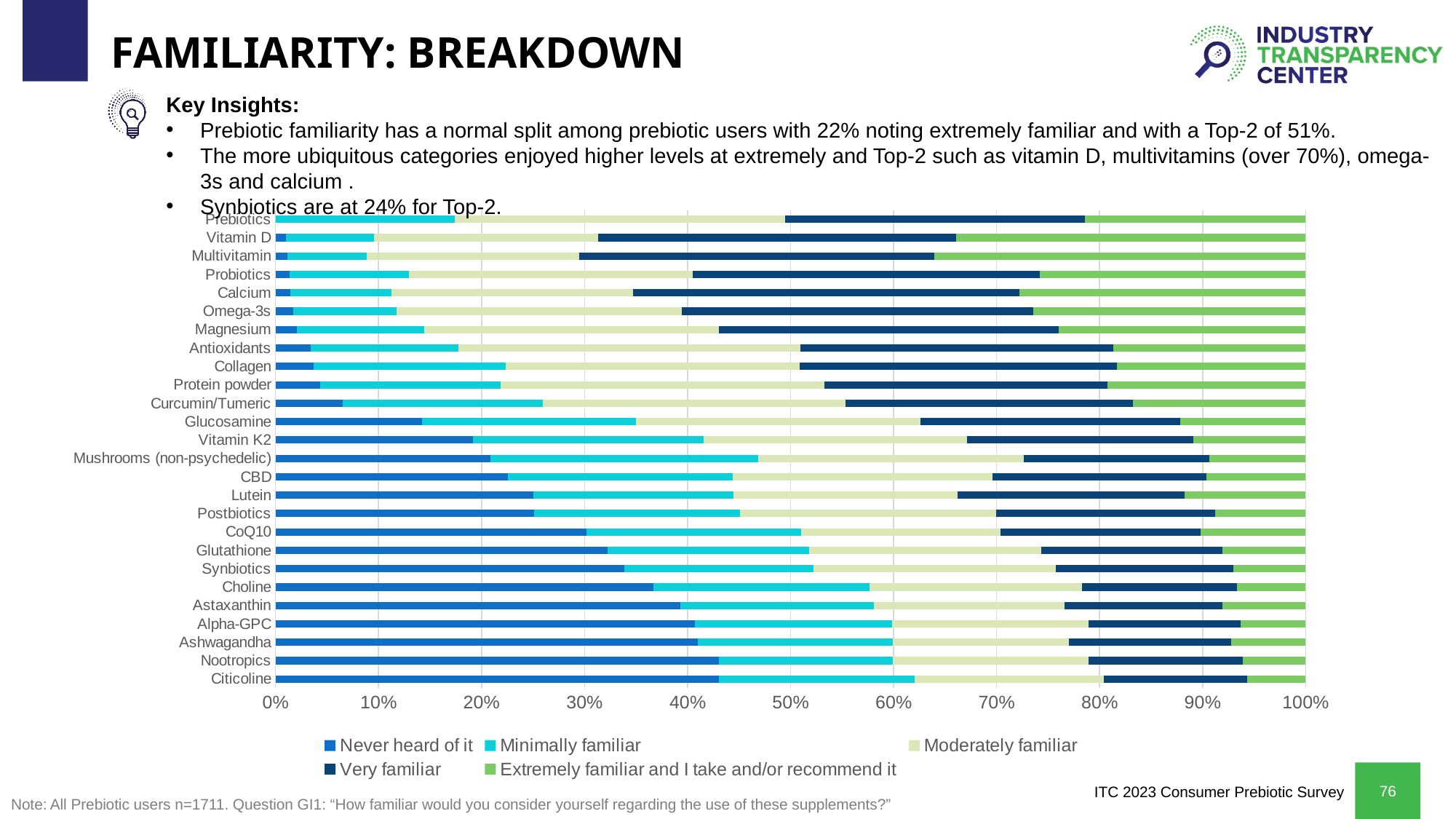
Is the 'Never heard of it' value for Choline greater or less than 40%? less Is the 'Never heard of it' value for Glucosamine greater or less than 20%? less How many series does the chart's legend list? 5 Which legend entry is shown in green at the end of each bar? Extremely familiar and I take and/or recommend it Which has a larger 'Never heard of it' share, Synbiotics or Prebiotics? Synbiotics What kind of chart is shown on the slide? Stacked bar chart How many supplement categories are plotted on the chart? 26 Which has a larger 'Never heard of it' share, Choline or Glucosamine? Choline Is the 'Never heard of it' value for Vitamin D greater or less than 10%? less What is the title of the slide's chart section? FAMILIARITY: BREAKDOWN Which has a larger 'Never heard of it' share, Citicoline or Vitamin D? Citicoline